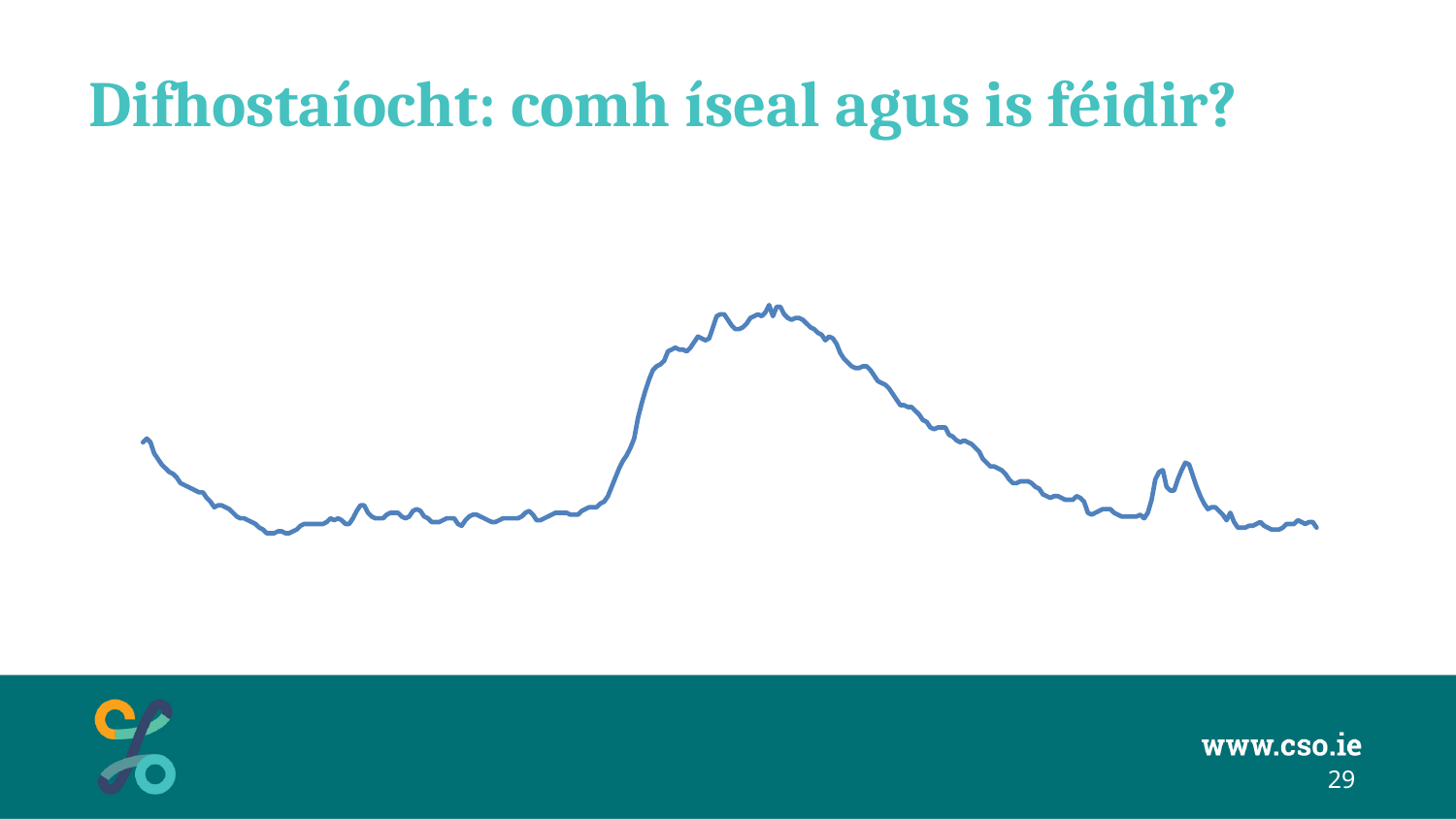
How many lines are plotted on the chart? 1 What kind of chart is shown on the slide? line chart What is the title of the slide containing the chart? Difhostaíocht: comh íseal agus is féidir? Does the line end higher or lower than where it starts at the left? lower What colour is the plotted line? blue Where along the x axis does the line reach its highest point: near the left, in the middle, or near the right? in the middle Does the line rise or fall from its peak in the middle towards the right end of the chart? fall